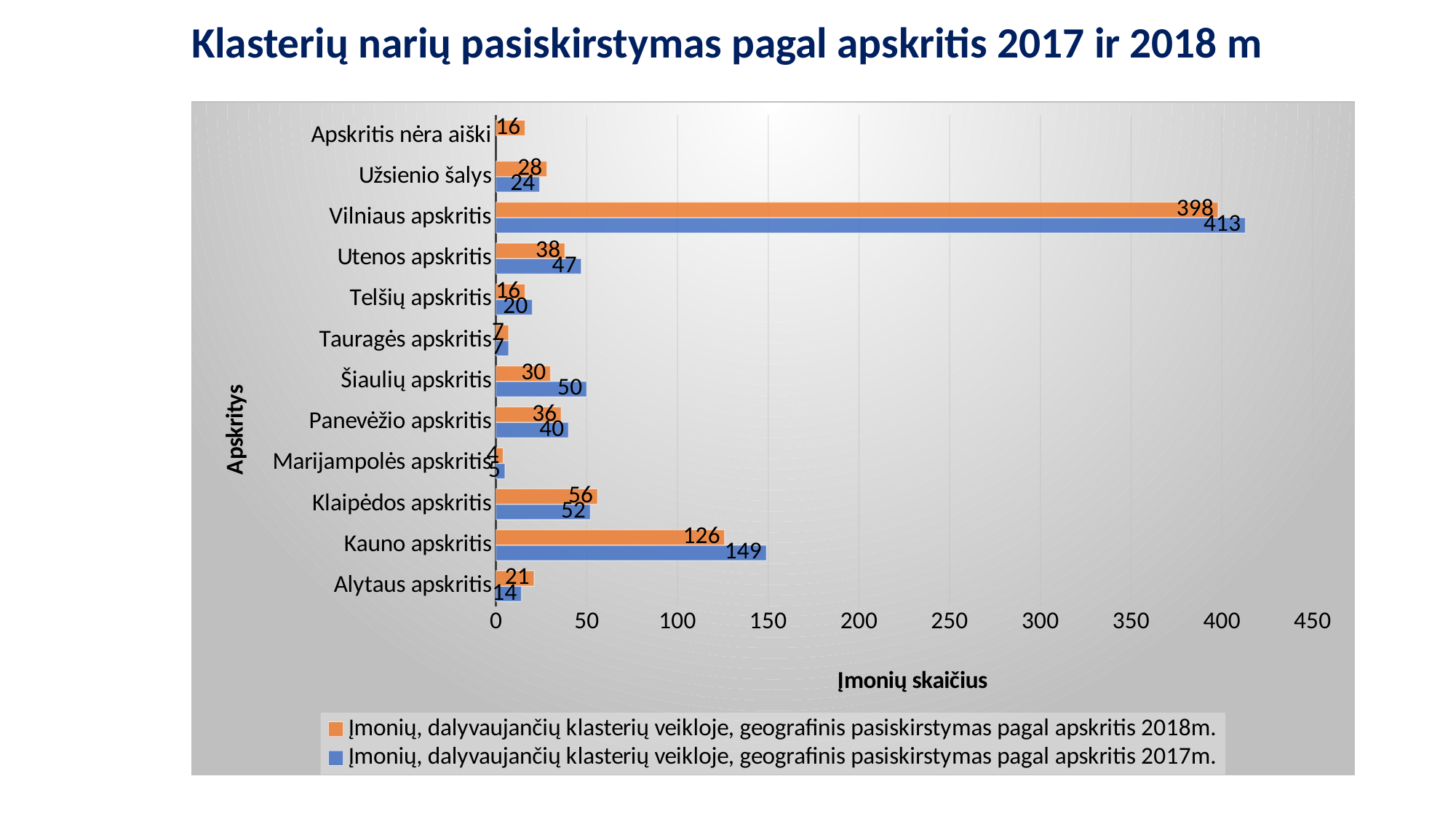
What is the difference between the 2017 and 2018 values for Kauno apskritis? 23 Which category has the highest 2018 value? Vilniaus apskritis Which is larger for Klaipėdos apskritis, the 2018 value or the 2017 value? 2018 value (56) How many categories (apskritys) are shown on the y axis? 12 What is the 2017 value for Šiaulių apskritis? 50 Is the 2017 value for Vilniaus apskritis greater or less than 400? greater What is the title of the x axis? Įmonių skaičius What is the 2018 value for Kauno apskritis? 126 Which category has the lowest 2018 value? Marijampolės apskritis How many series does the legend list? 2 What is the 2017 value for Vilniaus apskritis? 413 What type of chart is shown on the slide? bar chart